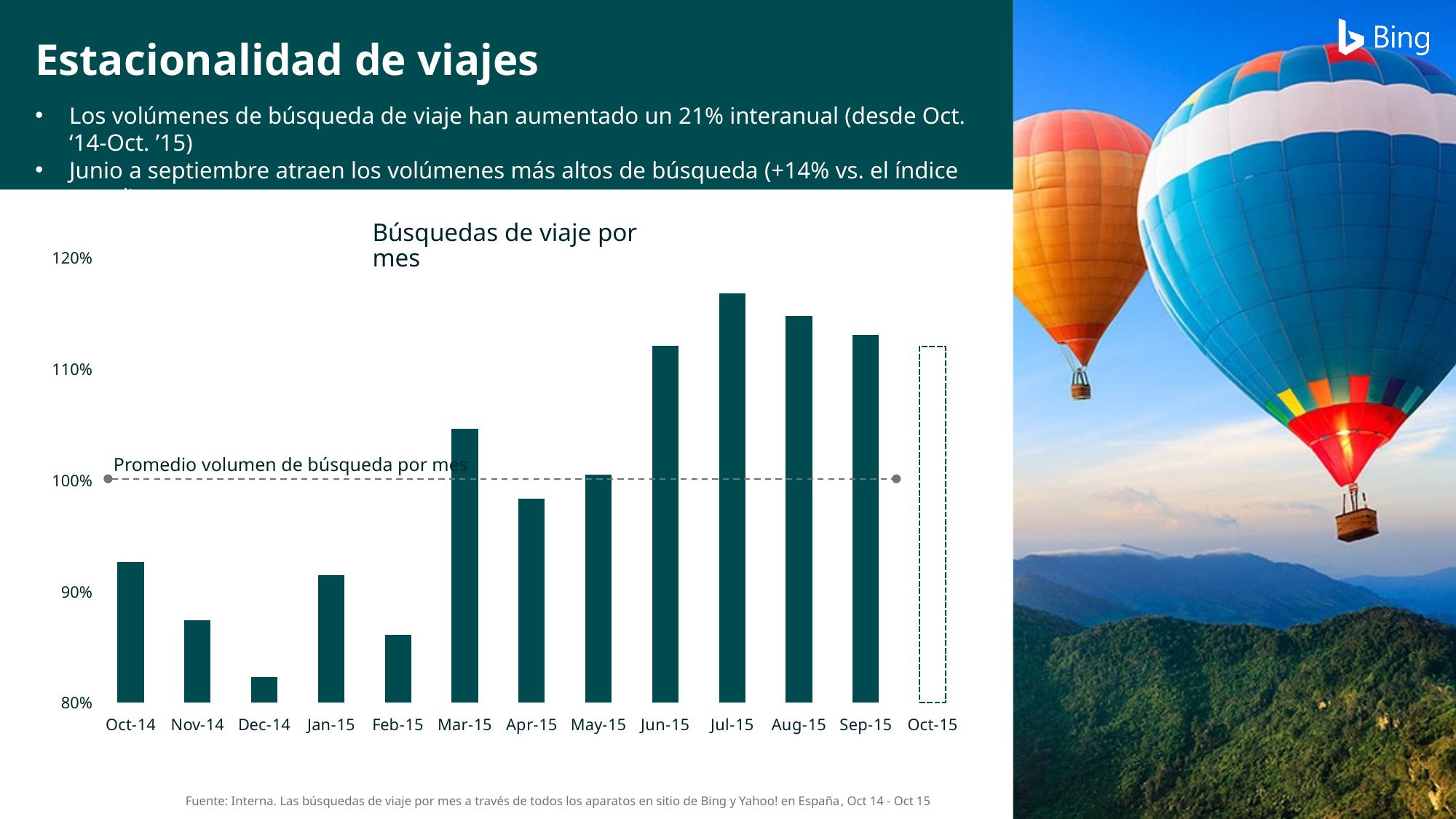
What kind of chart is 'Búsquedas de viaje por mes'? bar chart Do the bars rise or fall from Oct-14 to Dec-14? fall Is the value for Apr-15 greater or less than 100%? less Is the value for Jun-15 greater or less than 110%? greater Which month has the highest bar in the chart? Jul-15 What does the dashed horizontal line at 100% represent? Promedio volumen de búsqueda por mes How many months are shown on the x axis of the chart? 13 Is the value for Dec-14 greater or less than 90%? less What is the title of the chart? Búsquedas de viaje por mes Which is higher, the bar for Jul-15 or the bar for Aug-15? Jul-15 Which month has the lowest bar in the chart? Dec-14